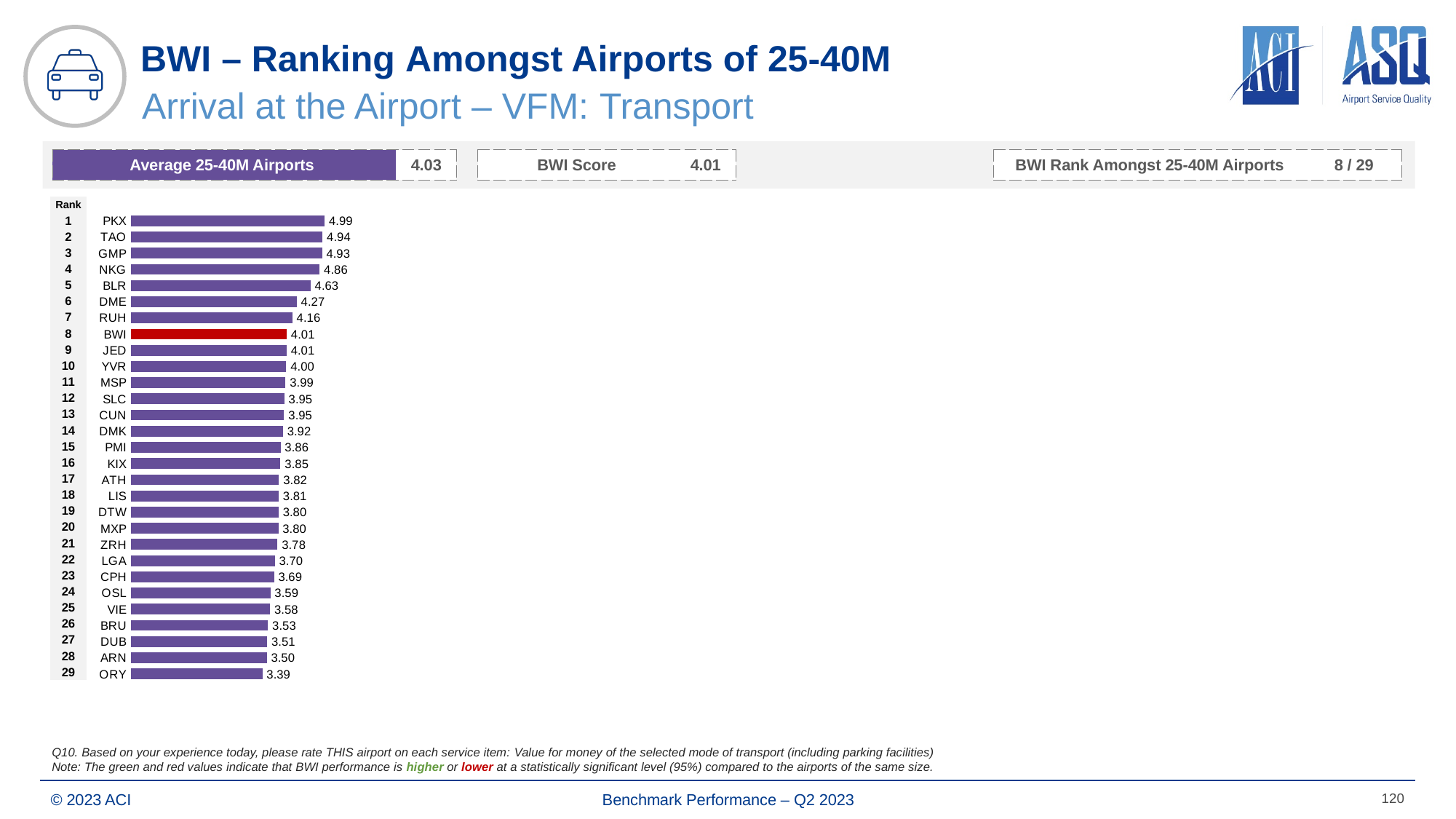
Which airport has the lowest value? ORY What is the value for BWI? 4.01 What is the difference between the values for PKX and ORY? 1.60 What is the value for PKX? 4.99 Which bar is coloured red in the chart? BWI Which airport has the highest value? PKX What is the value for ORY? 3.39 What kind of chart is shown on the slide? Bar chart What is the value for DME? 4.27 How many airports are shown in the chart? 29 What is the difference between the values for BLR and BWI? 0.62 Which is larger, the value for RUH or the value for LGA? RUH